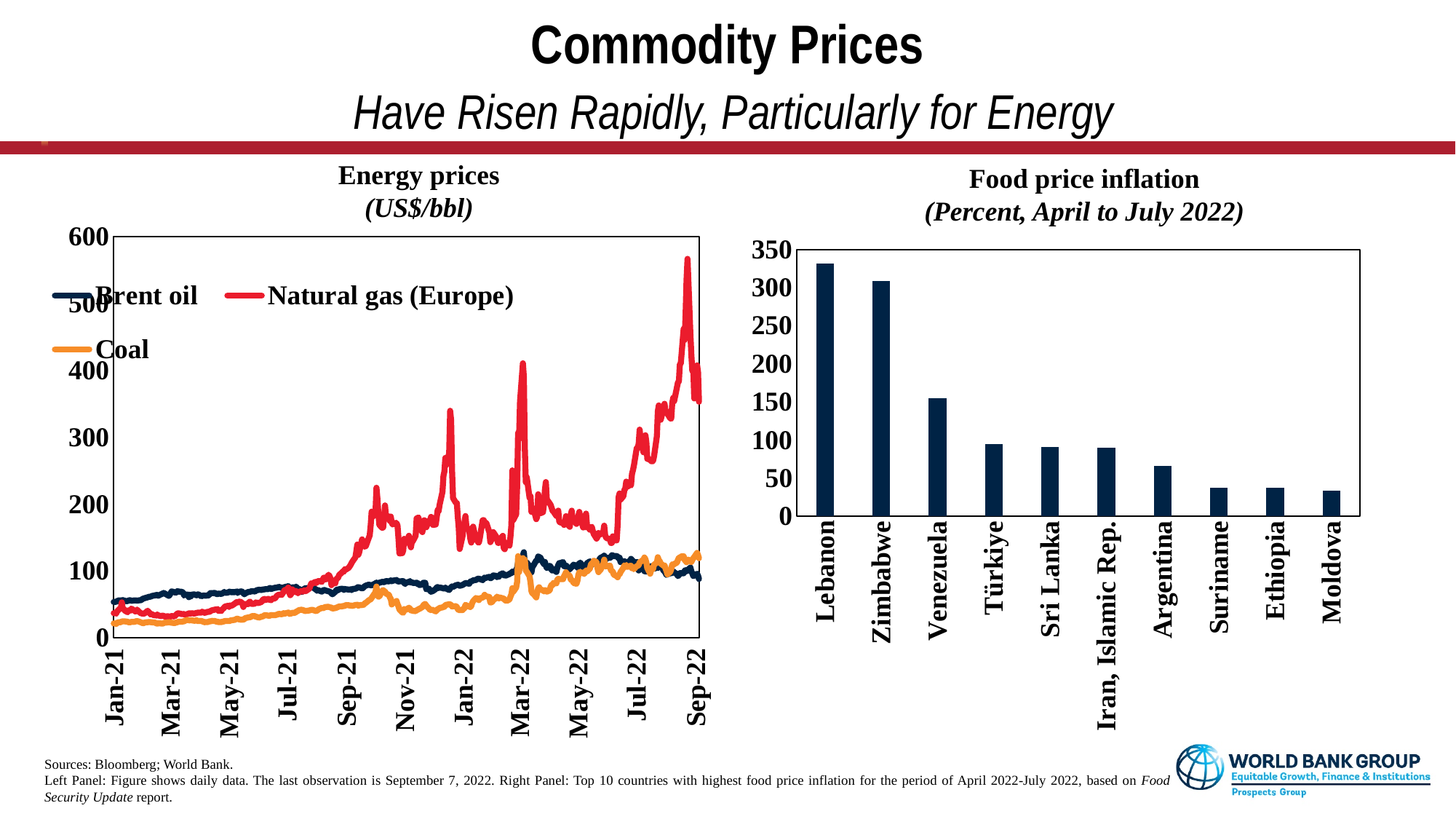
On the Food price inflation chart, is the value for Moldova greater or less than 50? less On the Energy prices chart, does the Natural gas (Europe) series generally rise or fall from Jan-21 to Sep-22? rise On the Food price inflation chart, how many countries are shown? 10 On the Food price inflation chart, is the value for Argentina greater or less than 50? greater On the Energy prices chart, which series has the highest value at Sep-22? Natural gas (Europe) On the Food price inflation chart, is the value for Venezuela greater or less than 200? less What kind of chart is the Food price inflation chart? bar chart What kind of chart is the Energy prices chart? line chart On the Food price inflation chart, which country has the highest food price inflation? Lebanon On the Food price inflation chart, which is larger, the value for Venezuela or the value for Türkiye? Venezuela How many series does the legend of the Energy prices chart list? 3